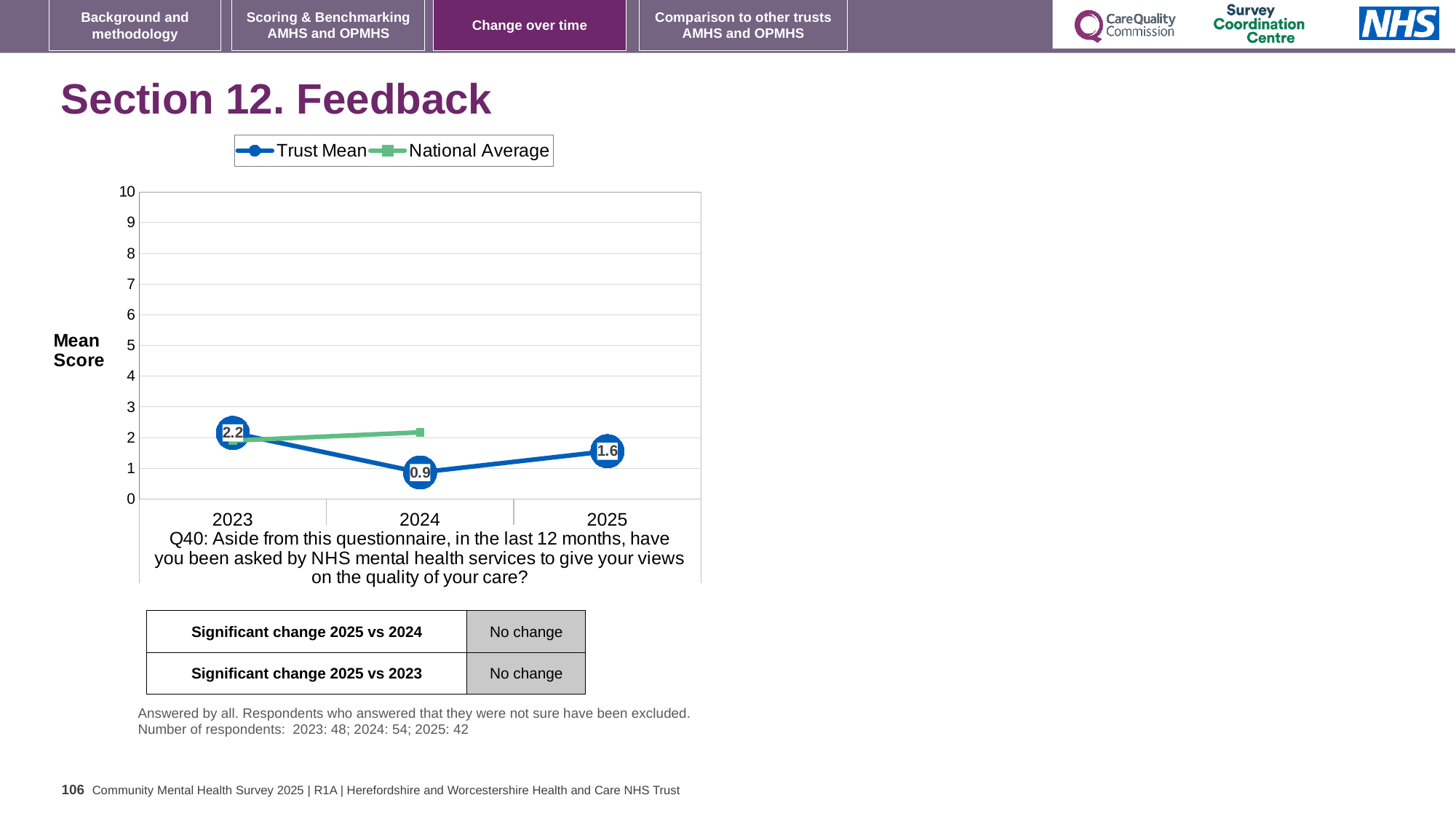
What is the Trust Mean score for 2024? 0.9 What is the difference between the Trust Mean scores for 2023 and 2024? 1.3 How many series does the legend list? 2 Which is larger, the Trust Mean score for 2025 or for 2024? 2025 What is the Trust Mean score for 2023? 2.2 What is the Trust Mean score for 2025? 1.6 What kind of chart is shown on the slide? Line chart In which year is the Trust Mean score lowest? 2024 Does the Trust Mean score rise or fall from 2023 to 2024? Fall In which year is the Trust Mean score highest? 2023 Is the National Average value for 2024 greater or less than 3? less How many years are shown on the x axis? 3